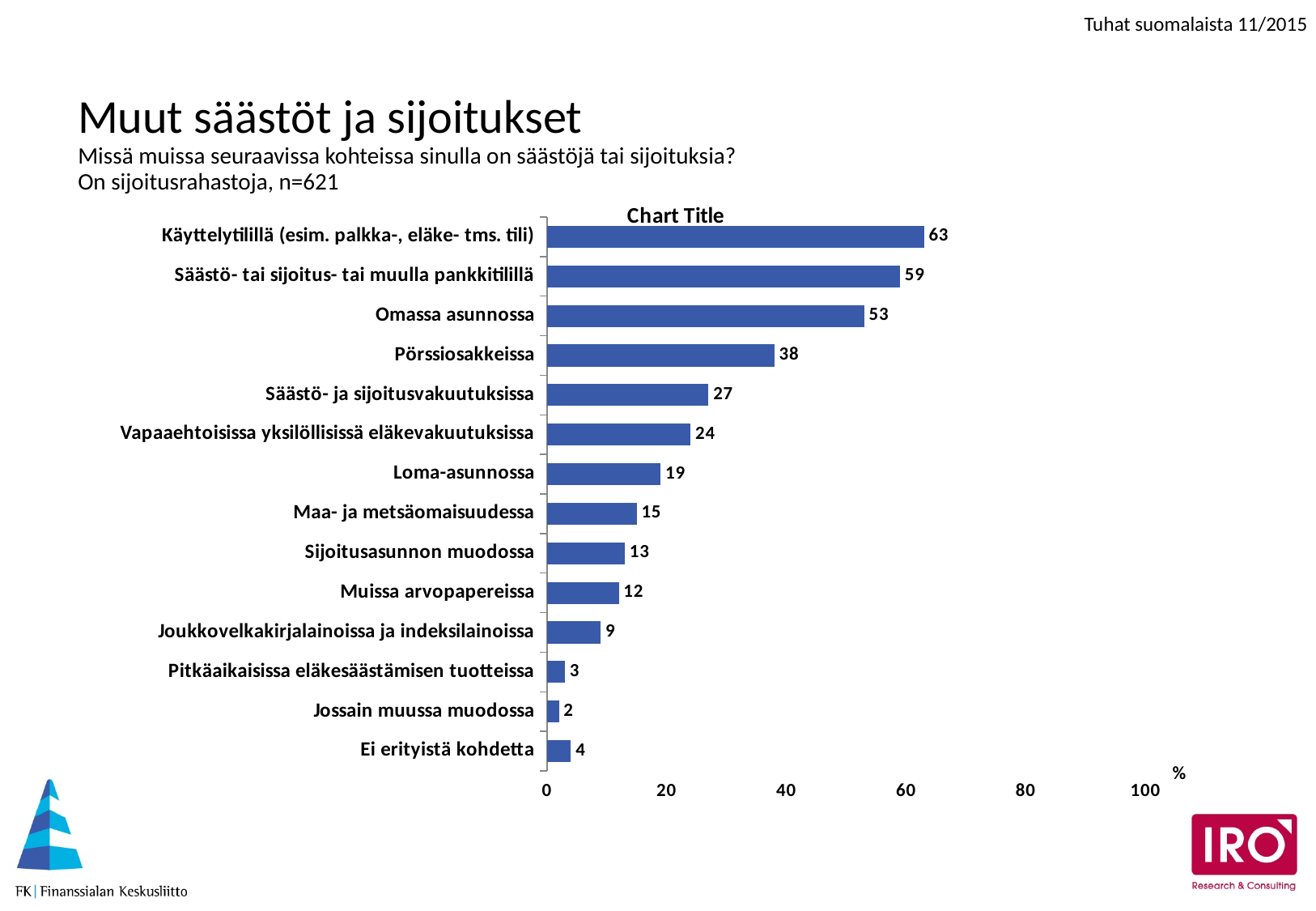
Which category has the lowest value? Jossain muussa muodossa What is the value for Omassa asunnossa? 53 Which category has the highest value? Käyttelytilillä (esim. palkka-, eläke- tms. tili) What is the title shown above the chart? Chart Title What is the value for Joukkovelkakirjalainoissa ja indeksilainoissa? 9 Which is larger, the value for Maa- ja metsäomaisuudessa or the value for Sijoitusasunnon muodossa? Maa- ja metsäomaisuudessa What kind of chart is shown on the slide? bar chart Is the value for Säästö- tai sijoitus- tai muulla pankkitilillä greater or less than 40? greater What is the value for Loma-asunnossa? 19 How many categories are shown in the chart? 14 What is the highest value labelled on the horizontal axis? 100 What is the difference between the values for Pörssiosakkeissa and Säästö- ja sijoitusvakuutuksissa? 11